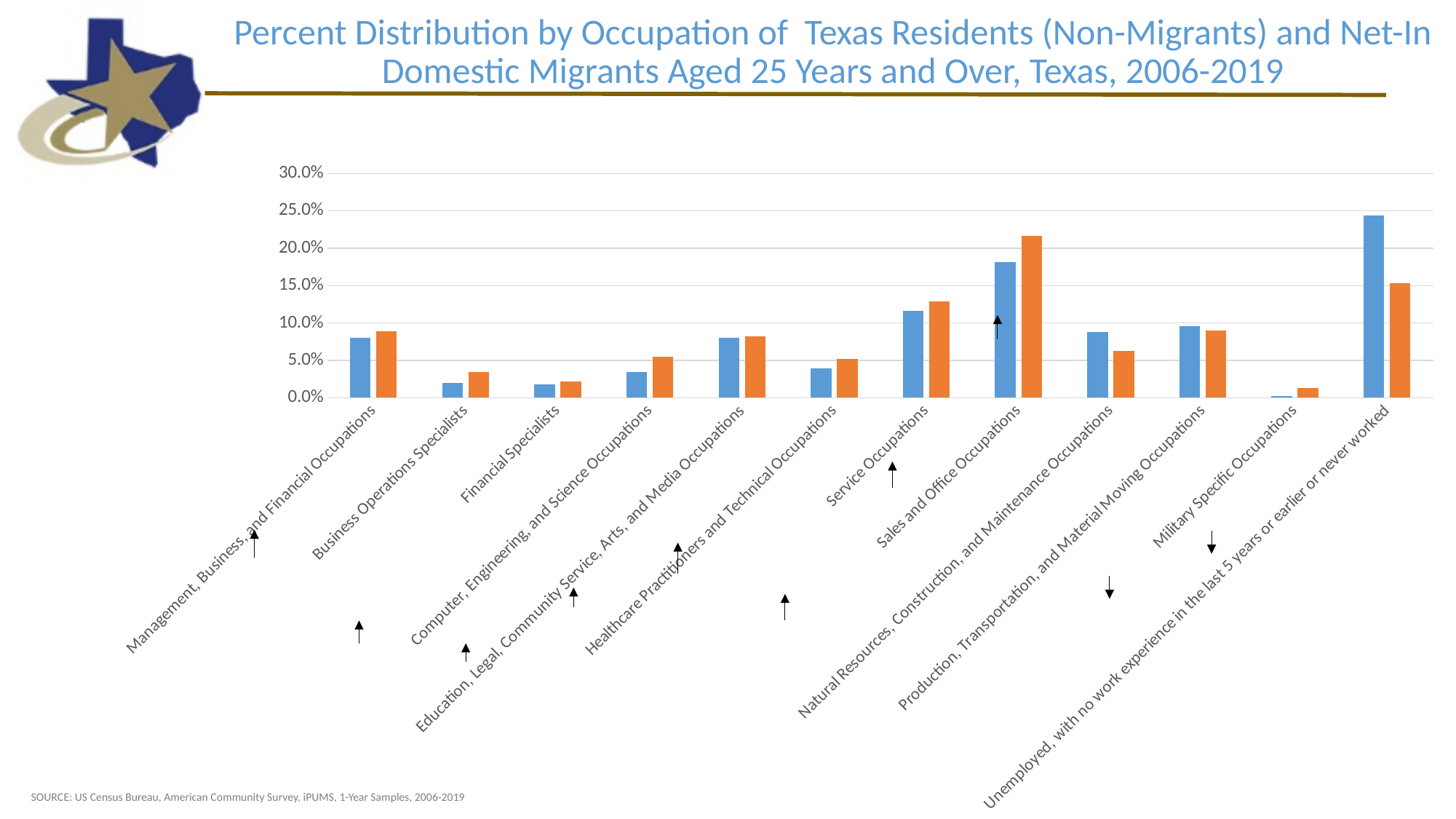
Is the orange bar for Computer, Engineering, and Science Occupations greater or less than 10.0%? less Which category has the shortest blue bar? Military Specific Occupations For Natural Resources, Construction, and Maintenance Occupations, which bar is taller, the blue or the orange? blue Which category has the tallest blue bar? Unemployed, with no work experience in the last 5 years or earlier or never worked Which category has the tallest orange bar? Sales and Office Occupations Which category has the shortest orange bar? Military Specific Occupations What is the highest value shown on the y axis? 30.0% What type of chart is shown on the slide? bar chart Is the blue bar for Sales and Office Occupations greater or less than 15.0%? greater How many occupation categories are shown on the x axis? 12 Is the orange bar for Unemployed, with no work experience in the last 5 years or earlier or never worked greater or less than 20.0%? less For Sales and Office Occupations, which bar is taller, the blue or the orange? orange